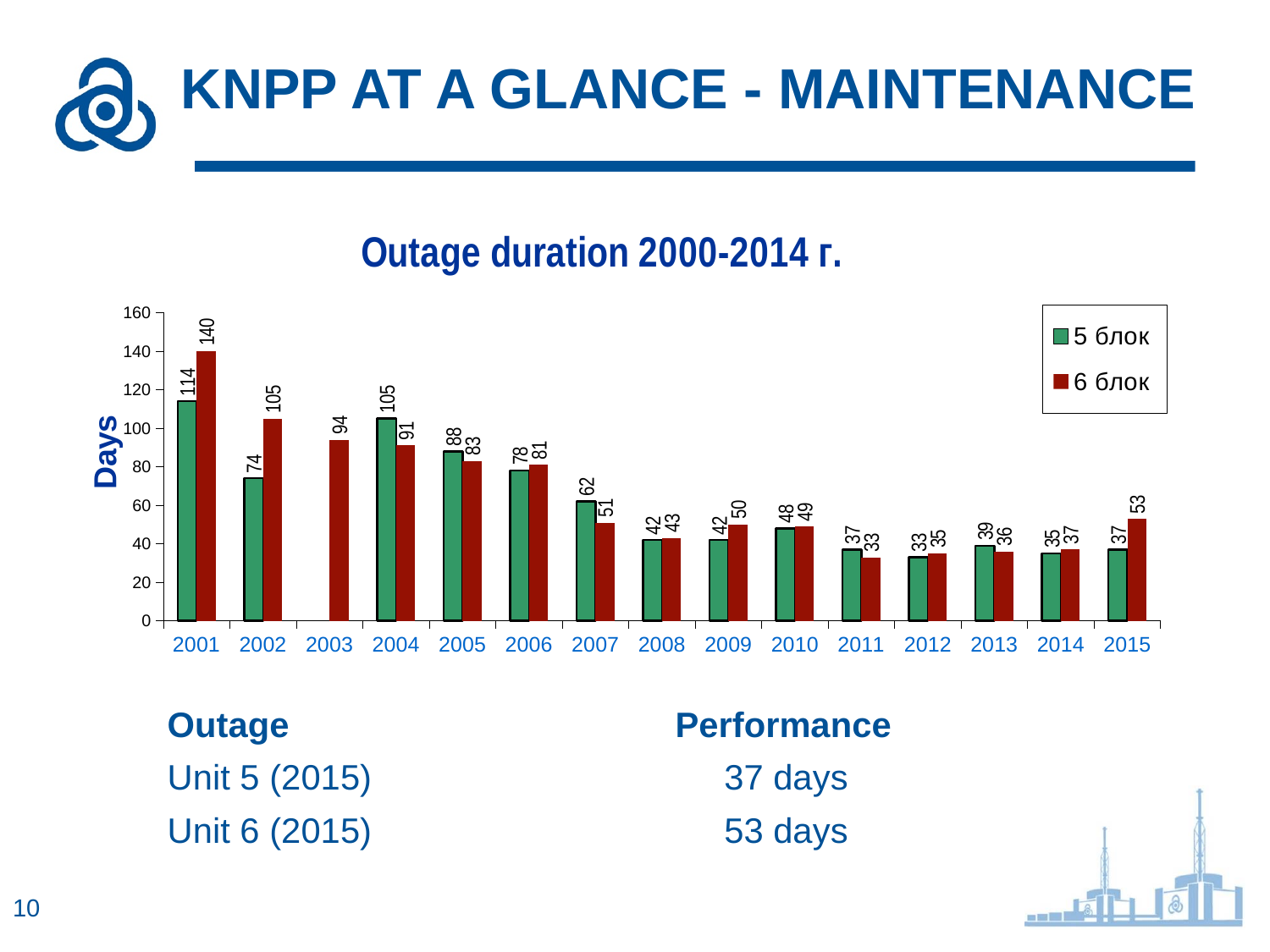
What is the outage duration for 5 блок in 2004? 105 Does the outage duration for 6 блок generally rise or fall from 2001 to 2012? Fall What is the difference between the 6 блок and 5 блок outage durations in 2015? 16 How many series does the legend list? 2 What kind of chart is shown on the slide? Bar chart Which has the larger outage duration in 2007, 5 блок or 6 блок? 5 блок How many years are shown on the x axis of the chart? 15 What is the title of the chart? Outage duration 2000-2014 г. What is the outage duration for 6 блок in 2001? 140 In which year is the outage duration for 5 блок the highest? 2001 In which year is the outage duration for 5 блок the lowest? 2012 What is the outage duration for 6 блок in 2003? 94